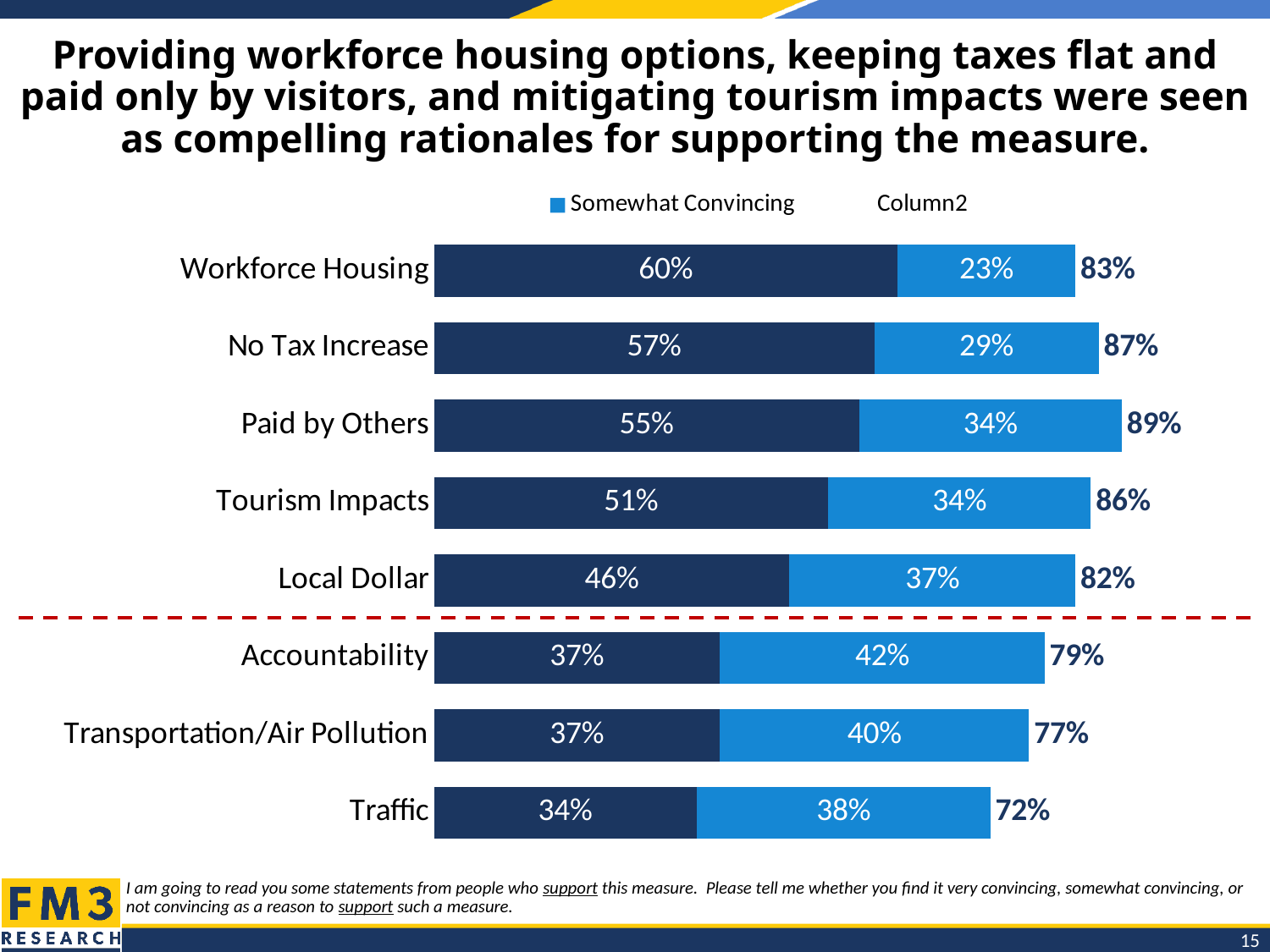
What is the value of the dark navy segment for Tourism Impacts? 51% What is the total percentage shown at the end of the bar for Paid by Others? 89% Which category has the lowest total percentage shown at the end of its bar? Traffic What is the Somewhat Convincing value for Local Dollar? 37% Which has a larger dark navy segment, Workforce Housing or No Tax Increase? Workforce Housing Which category has the highest total percentage shown at the end of its bar? Paid by Others What kind of chart is shown on the slide? Stacked bar chart What is the Somewhat Convincing value for Workforce Housing? 23% Which category has the highest Somewhat Convincing value? Accountability How many categories are shown in the chart? 8 What is the total percentage shown at the end of the bar for Transportation/Air Pollution? 77% What is the difference between the Somewhat Convincing values for Accountability and Traffic? 4 percentage points